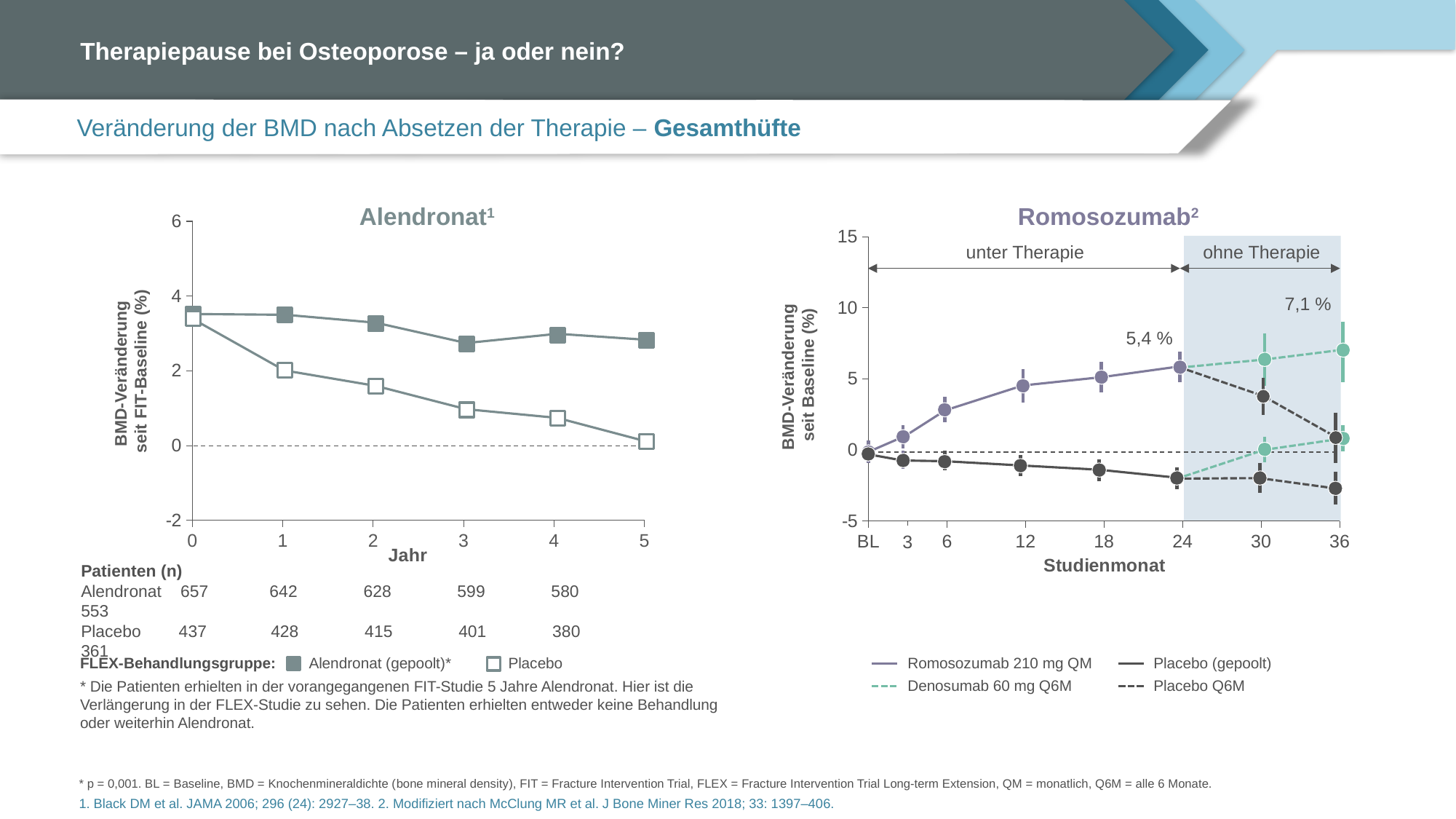
In the Romosozumab chart, how many series does the legend list? 4 What kind of chart is the Alendronat chart on the left? line chart In the Romosozumab chart, what value is labelled for Romosozumab 210 mg QM at month 24? 5,4 % In the Romosozumab chart, does the Romosozumab 210 mg QM line rise or fall from BL to month 24? rise In the Alendronat chart, at year 5, which series has the higher value: Alendronat (gepoolt) or Placebo? Alendronat (gepoolt) In the Alendronat chart, how many time points (years) are plotted on the x axis? 6 In the Alendronat chart, what is the x-axis title? Jahr In the Romosozumab chart, is the Placebo (gepoolt) value at month 24 greater or less than 0? less In the Romosozumab chart, what value is labelled at month 36 for the Denosumab 60 mg Q6M line? 7,1 % In the Alendronat chart, does the Placebo line rise or fall from year 0 to year 5? fall In the Alendronat chart, is the Placebo value at year 5 greater or less than 2? less In the Alendronat chart, how many series does the legend list? 2